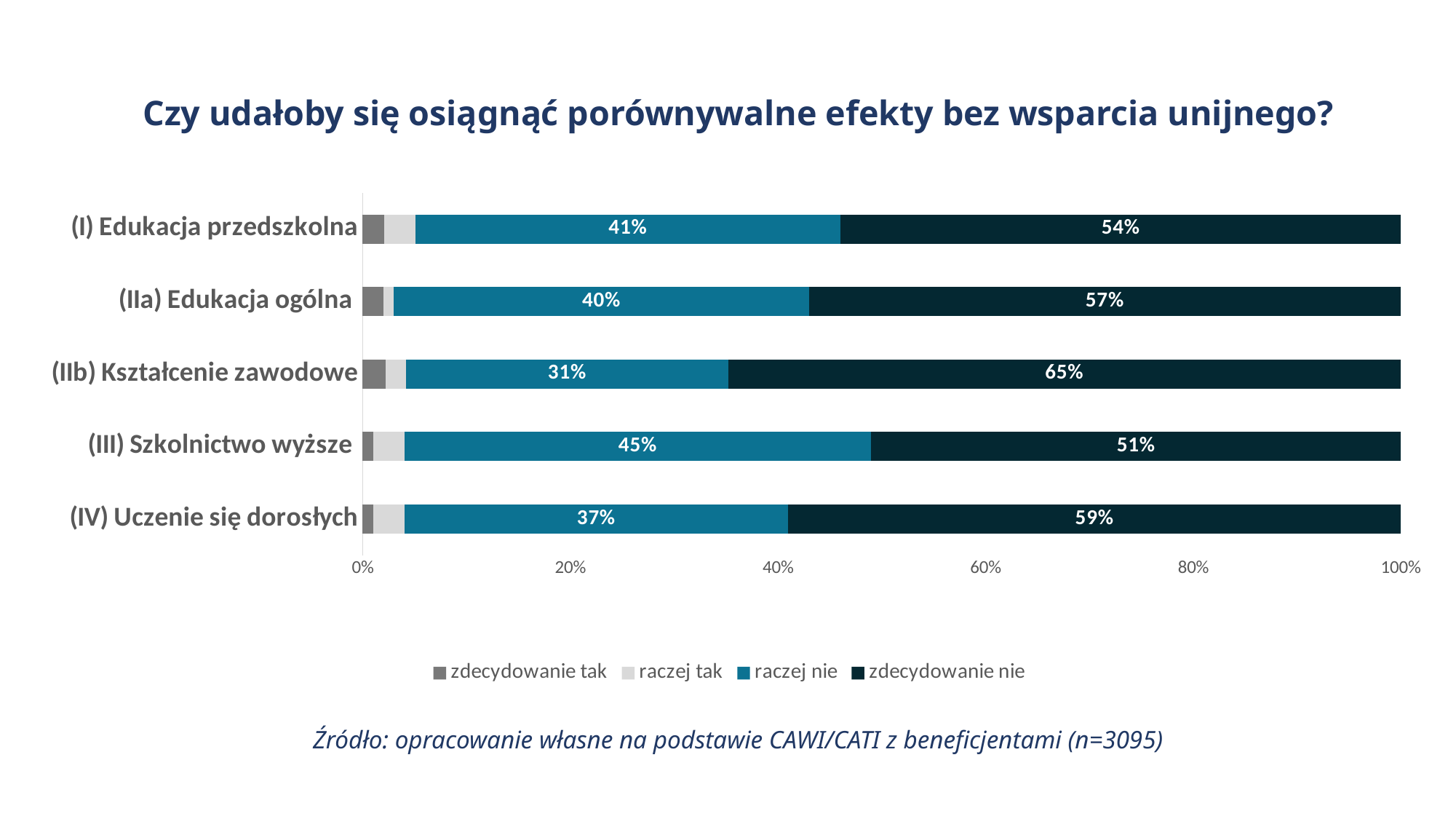
How many series does the legend list? 4 What kind of chart is shown on the slide? Stacked bar chart Which category has the lowest 'raczej nie' value? (IIb) Kształcenie zawodowe What is the 'zdecydowanie nie' value for (IIb) Kształcenie zawodowe? 65% What is the 'zdecydowanie nie' value for (I) Edukacja przedszkolna? 54% Which category has the highest 'zdecydowanie nie' value? (IIb) Kształcenie zawodowe What is the difference between the 'zdecydowanie nie' values for (IIb) Kształcenie zawodowe and (III) Szkolnictwo wyższe? 14% How many categories are shown on the chart? 5 What is the 'raczej nie' value for (IV) Uczenie się dorosłych? 37% What is the 'raczej nie' value for (III) Szkolnictwo wyższe? 45% What is the title of the chart? Czy udałoby się osiągnąć porównywalne efekty bez wsparcia unijnego? Which is larger: the 'raczej nie' value for (I) Edukacja przedszkolna or for (IIa) Edukacja ogólna? (I) Edukacja przedszkolna